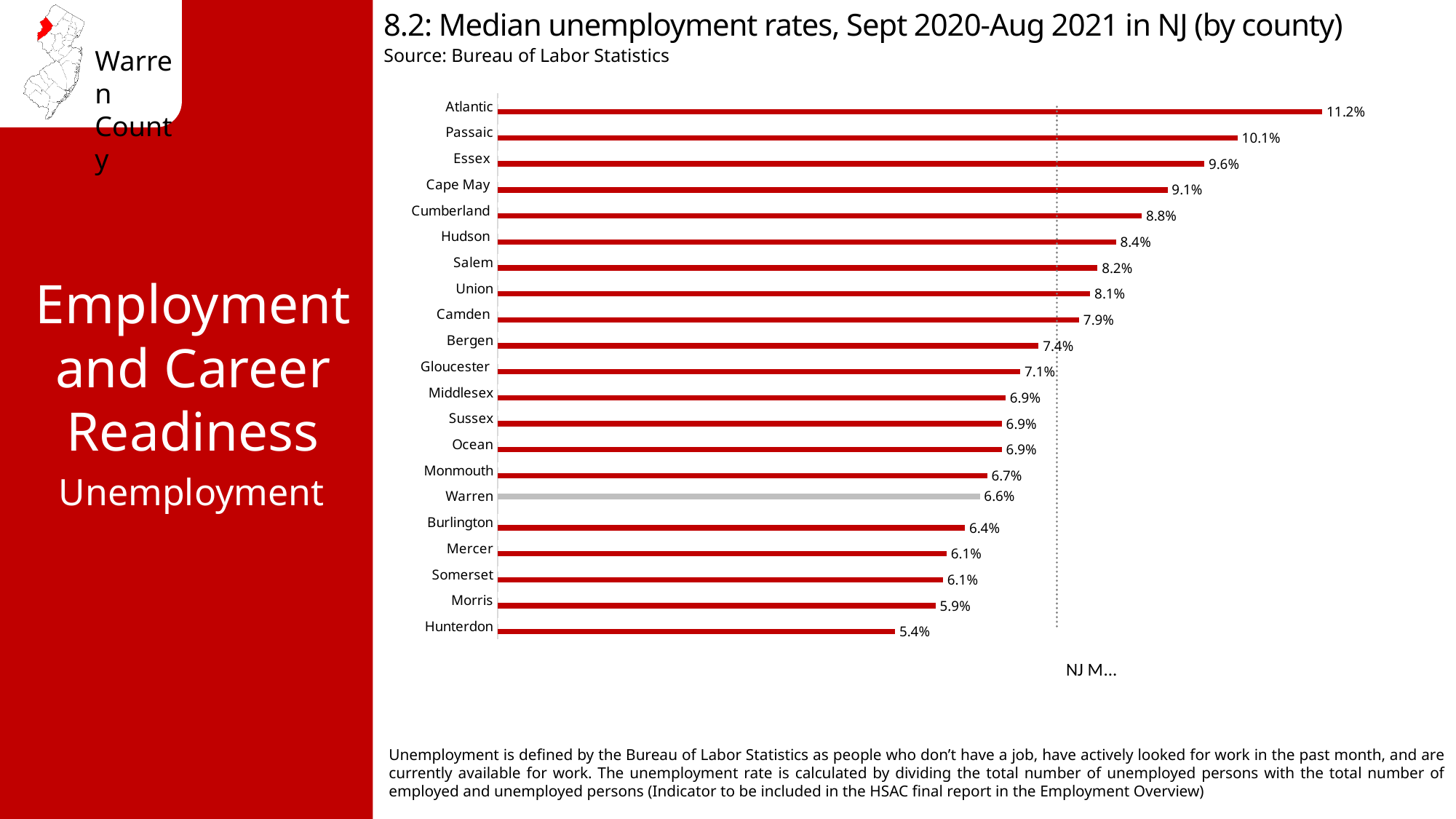
What is the median unemployment rate for Hudson County? 8.4% How many counties are shown in the chart? 21 What type of chart is used to show the median unemployment rates? Bar chart What is the difference between the median unemployment rates of Atlantic and Hunterdon counties? 5.8% What is the median unemployment rate for Atlantic County? 11.2% Which county has the highest median unemployment rate? Atlantic Which county has a higher median unemployment rate, Cape May or Cumberland? Cape May Which county has a higher median unemployment rate, Morris or Burlington? Burlington Which county's bar is shown in grey rather than red? Warren Which county has the lowest median unemployment rate? Hunterdon What is the median unemployment rate for Warren County? 6.6% What is the difference between the median unemployment rates of Passaic and Warren counties? 3.5%